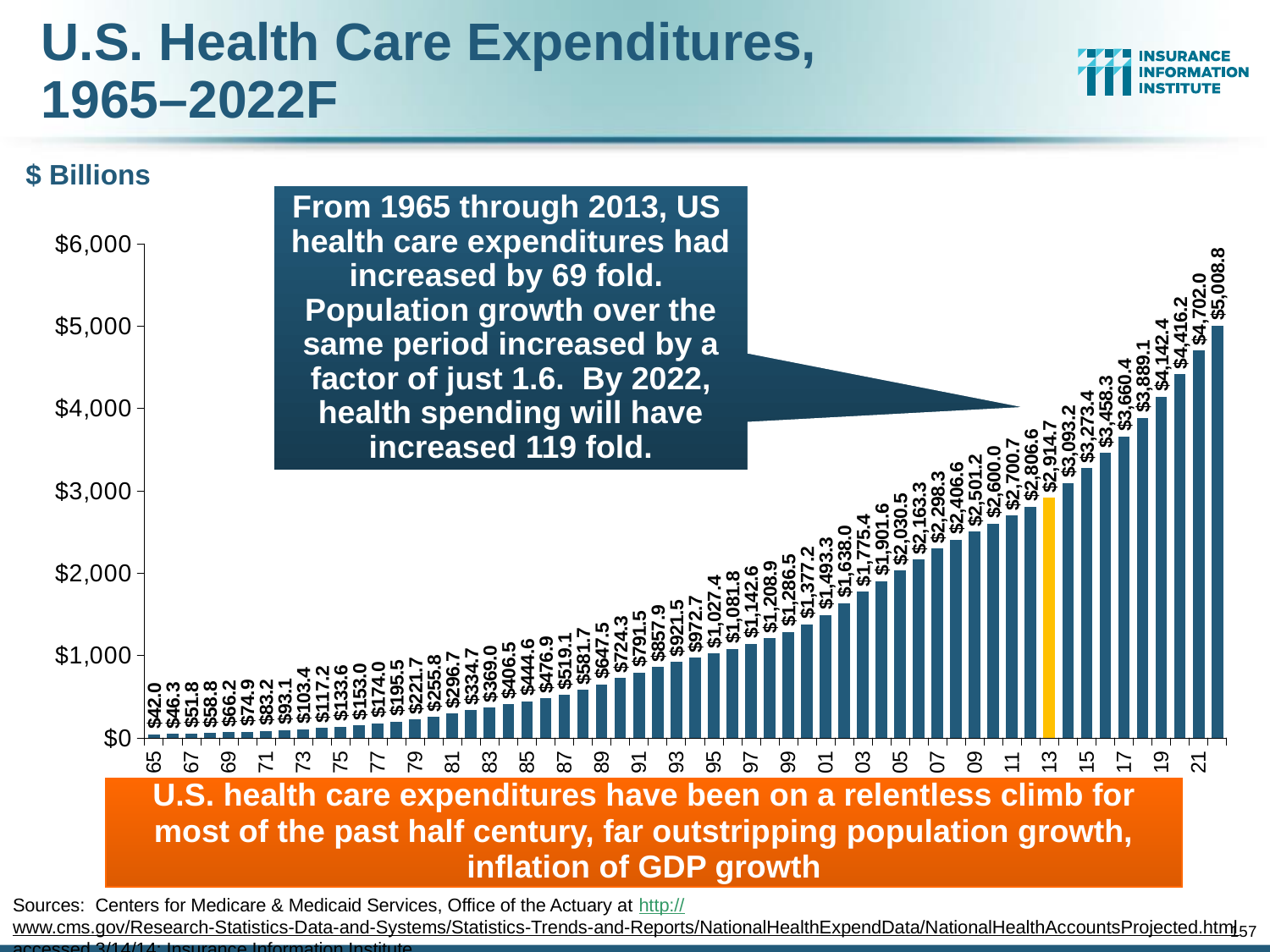
How many bars (years) are plotted in the chart? 58 What is the value for 1965 (the first bar)? $42.0 What is the value for 2022F (the last bar)? $5,008.8 What is the value for 2013, the highlighted bar? $2,914.7 Which year has the lowest value? 1965 (65) What is the difference between the 2022 value and the 2013 value? $2,094.1 Is the value for 2010 greater or less than $2,000? greater Which is larger, the value for 1995 or the value for 2005? 2005 What is the value for 2000? $1,377.2 What kind of chart is shown on the slide? bar chart Which year has the highest value? 2022 (22) Do the values rise or fall from 1965 to 2022? rise